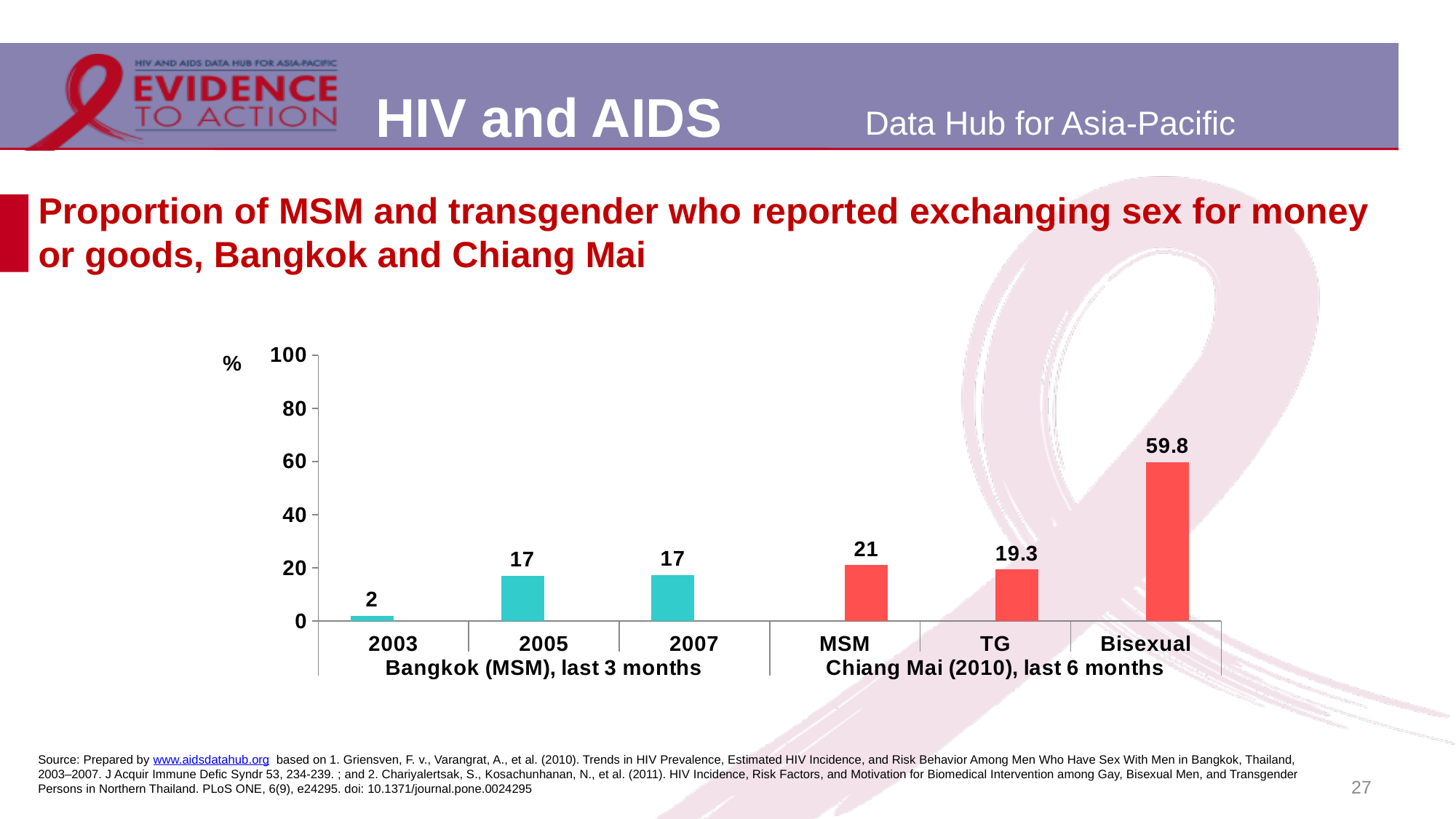
What unit is shown on the y axis of the chart? % What kind of chart is shown on the slide? Bar chart Which is larger, the value for MSM in Chiang Mai or the value for Bangkok MSM in 2007? MSM in Chiang Mai Which category has the highest value? Bisexual What is the value for TG in Chiang Mai (2010)? 19.3 What is the value for Bangkok MSM in 2003? 2 What is the value for Bisexual in Chiang Mai (2010)? 59.8 What is the difference between the Bisexual value and the TG value in Chiang Mai? 40.5 How many bars are plotted in the chart? 6 What is the value for MSM in Chiang Mai (2010)? 21 Is the value for Bisexual greater or less than 40? greater Which category has the lowest value? 2003